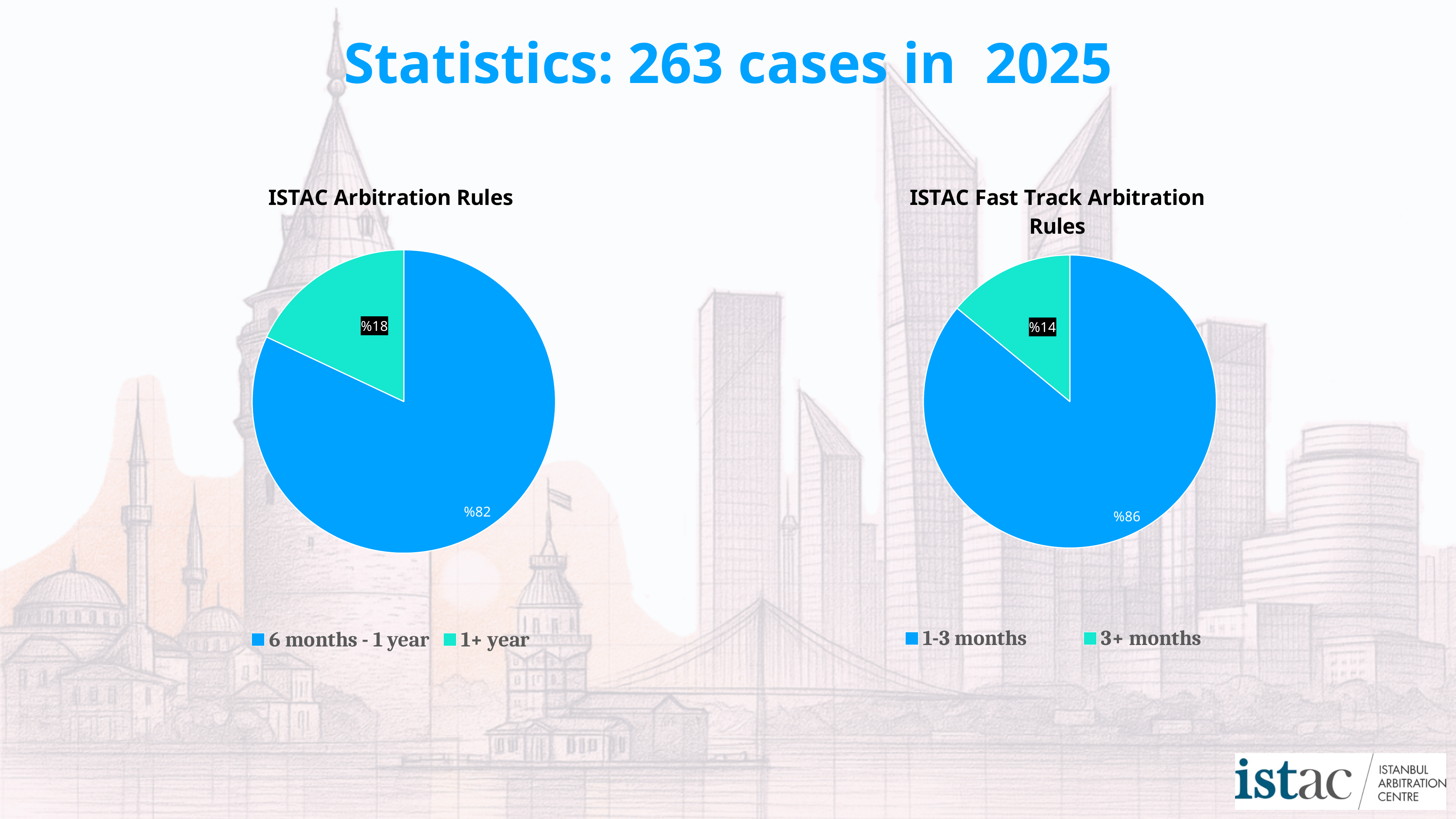
What is the title of the slide? Statistics: 263 cases in 2025 Which is larger: the '1+ year' share in the 'ISTAC Arbitration Rules' chart or the '3+ months' share in the 'ISTAC Fast Track Arbitration Rules' chart? 1+ year In the 'ISTAC Arbitration Rules' chart, what is the difference in percentage points between the '6 months - 1 year' and '1+ year' slices? 64 What kind of chart is the 'ISTAC Arbitration Rules' chart? Pie chart In the 'ISTAC Arbitration Rules' chart, what share is labelled for '1+ year'? %18 In the 'ISTAC Fast Track Arbitration Rules' chart, which category has the smallest slice? 3+ months In the 'ISTAC Arbitration Rules' chart, which category has the largest slice? 6 months - 1 year In the 'ISTAC Fast Track Arbitration Rules' chart, what is the difference in percentage points between the '1-3 months' and '3+ months' slices? 72 In the 'ISTAC Fast Track Arbitration Rules' chart, what share is labelled for '1-3 months'? %86 How many categories does the legend of the 'ISTAC Fast Track Arbitration Rules' chart list? 2 In the 'ISTAC Fast Track Arbitration Rules' chart, what share is labelled for '3+ months'? %14 In the 'ISTAC Arbitration Rules' chart, what share is labelled for '6 months - 1 year'? %82